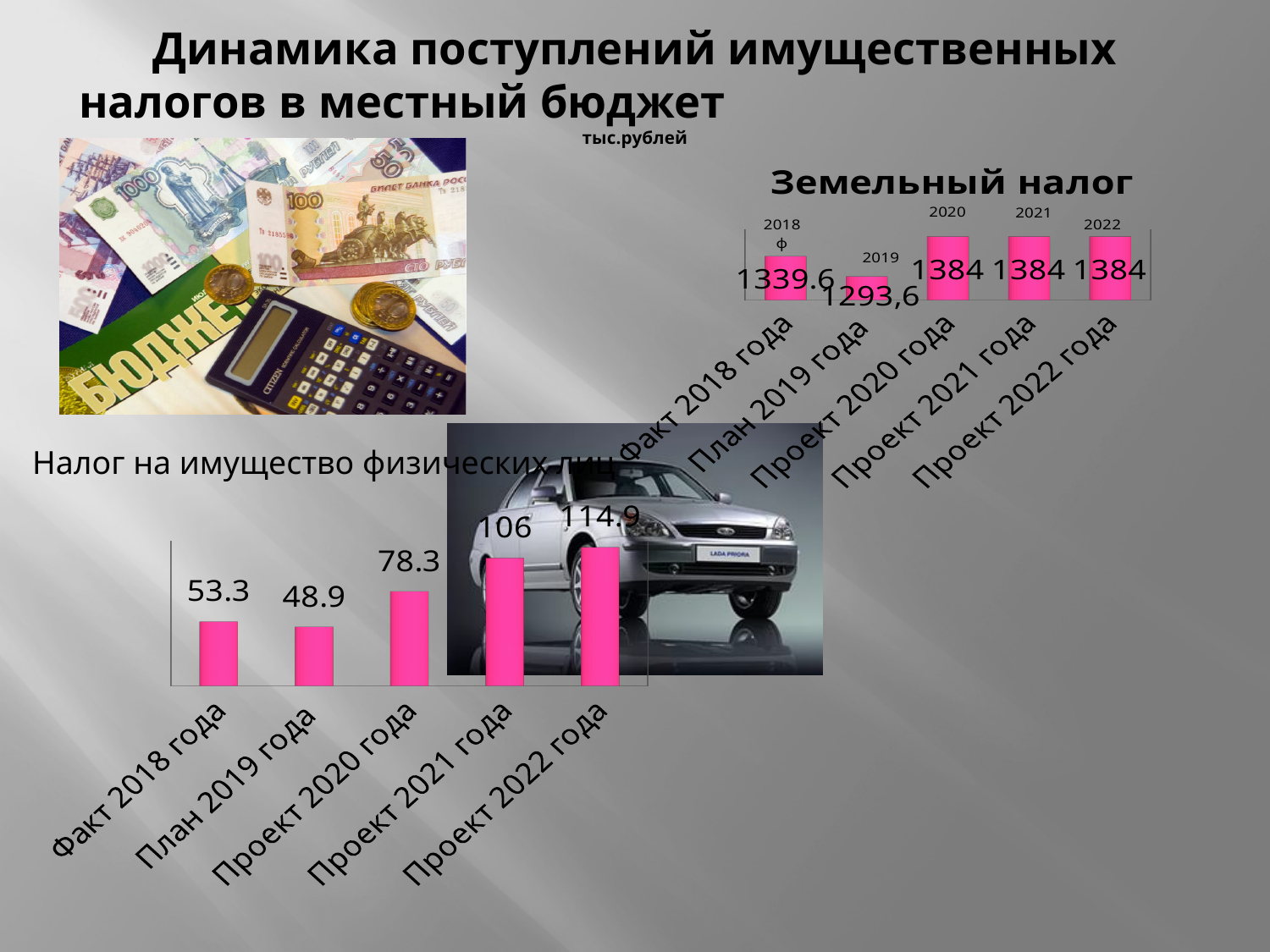
In the 'Налог на имущество физических лиц' chart, what is the difference between Проект 2022 года and Проект 2021 года? 8.9 In the 'Земельный налог' chart, what is the value for Проект 2021 года? 1384 In the 'Земельный налог' chart, how many categories are plotted? 5 In the 'Земельный налог' chart, what is the value for Факт 2018 года? 1339.6 What type of chart is the 'Налог на имущество физических лиц' chart? Bar chart In the 'Налог на имущество физических лиц' chart, which category has the lowest value? План 2019 года In the 'Земельный налог' chart, what is the value for План 2019 года? 1293,6 In the 'Налог на имущество физических лиц' chart, which is larger: Факт 2018 года or План 2019 года? Факт 2018 года In the 'Налог на имущество физических лиц' chart, which category has the highest value? Проект 2022 года In the 'Налог на имущество физических лиц' chart, what is the value for Проект 2020 года? 78.3 In the 'Земельный налог' chart, which category has the lowest value? План 2019 года In the 'Налог на имущество физических лиц' chart, what is the value for Проект 2022 года? 114.9